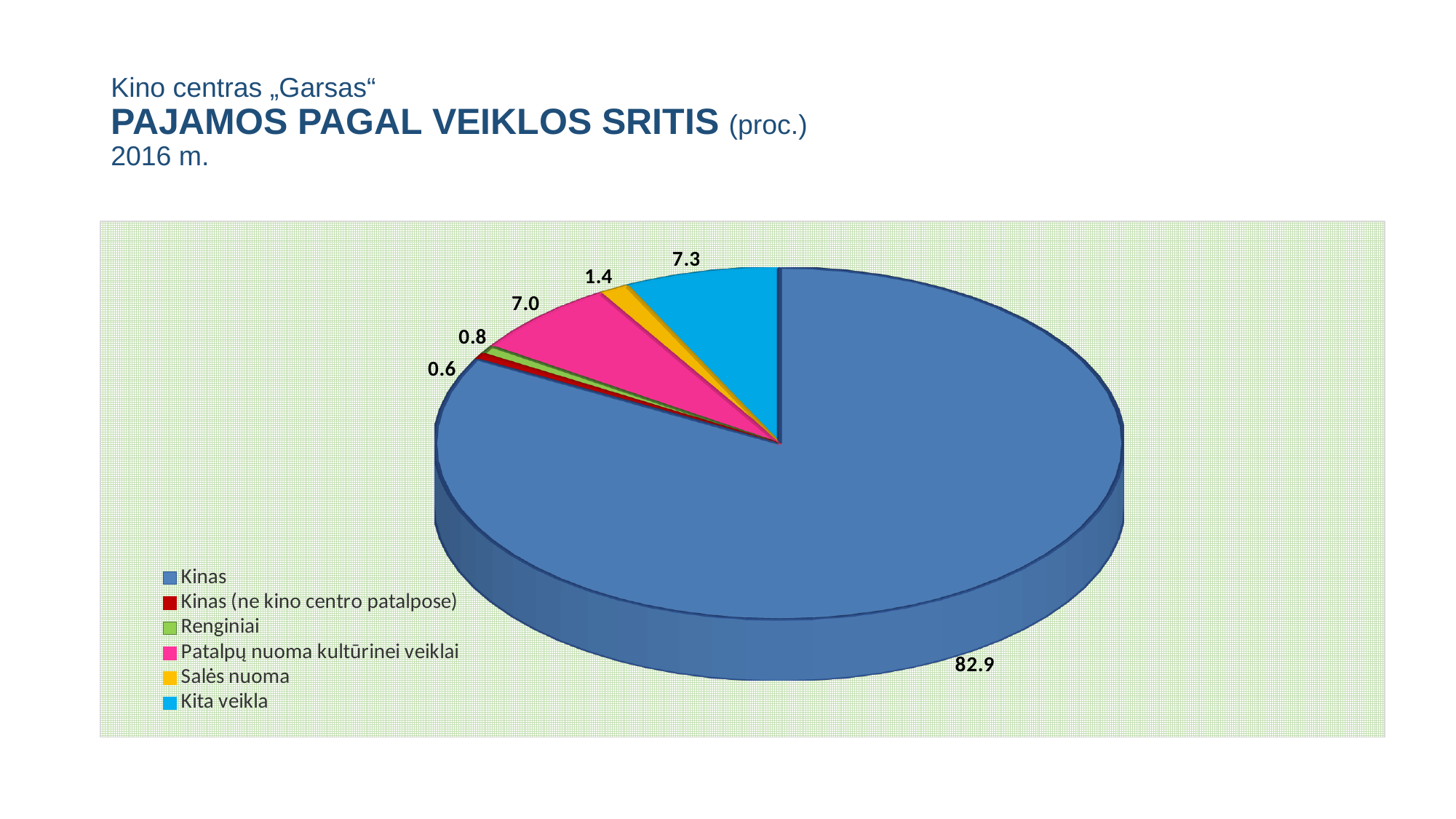
What is the difference between the values for Kita veikla and Patalpų nuoma kultūrinei veiklai? 0.3 What is the value for Kita veikla? 7.3 What type of chart is shown on the slide? pie chart What is the value for Renginiai? 0.8 Which category has the smallest share of the pie? Kinas (ne kino centro patalpose) What is the value for Patalpų nuoma kultūrinei veiklai? 7.0 What is the value for Kinas? 82.9 What is the value for Kinas (ne kino centro patalpose)? 0.6 What is the value for Salės nuoma? 1.4 What year is shown in the chart title? 2016 m. How many categories does the legend list? 6 Which category has the largest share of the pie? Kinas